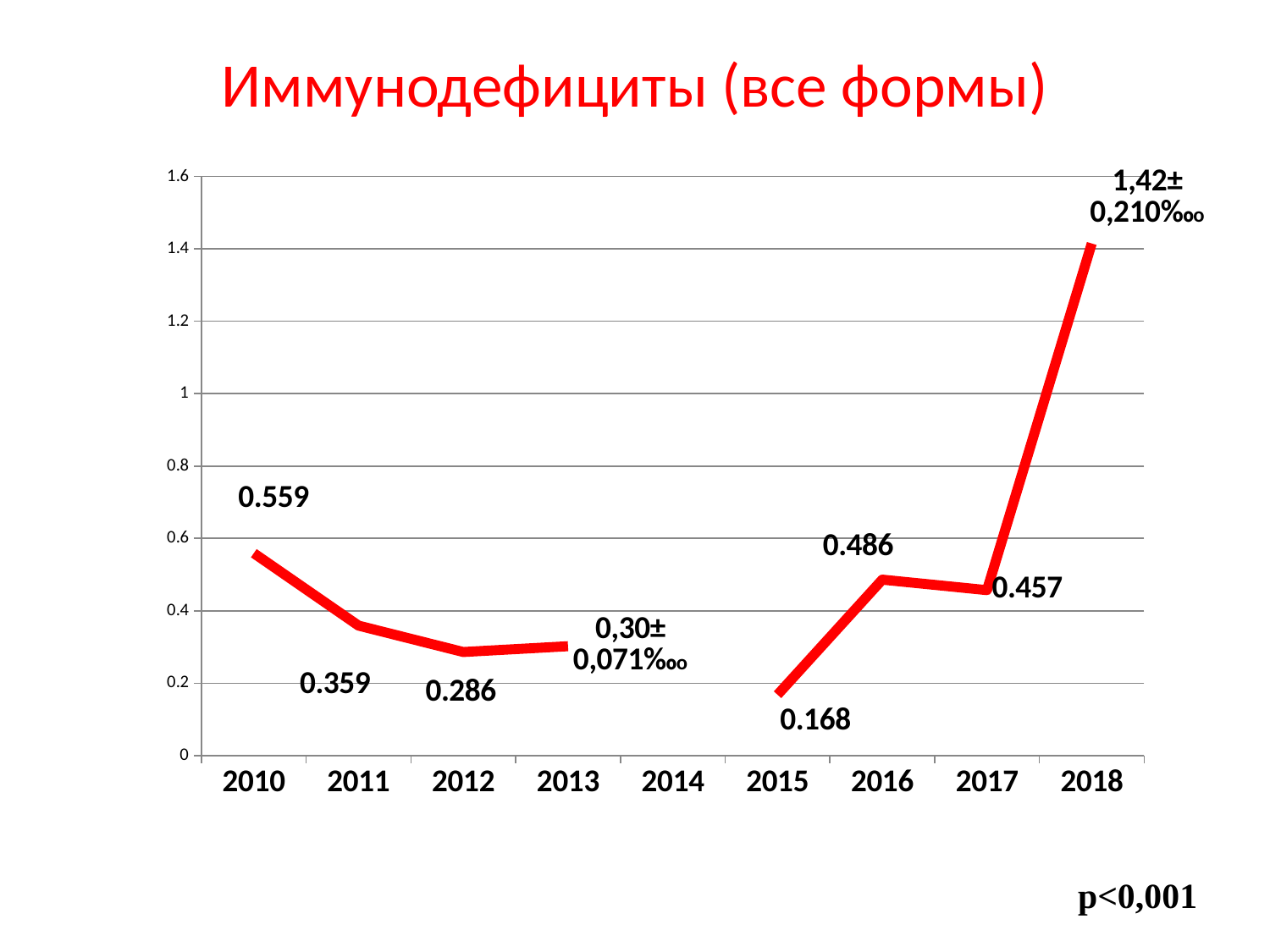
Which year has the highest value? 2018 What is the value for 2010? 0.559 What is the difference between the values for 2010 and 2011? 0.200 What is the value for 2015? 0.168 Which year has the lowest value? 2015 Is the value for 2018 greater or less than 1.2? greater Do the values rise or fall from 2010 to 2012? fall What type of chart is shown on the slide? line chart What is the value labelled for 2018? 1,42±0,210‰ What is the title of the chart? Иммунодефициты (все формы) What is the value for 2016? 0.486 Which is larger, the value for 2012 or the value for 2017? 2017